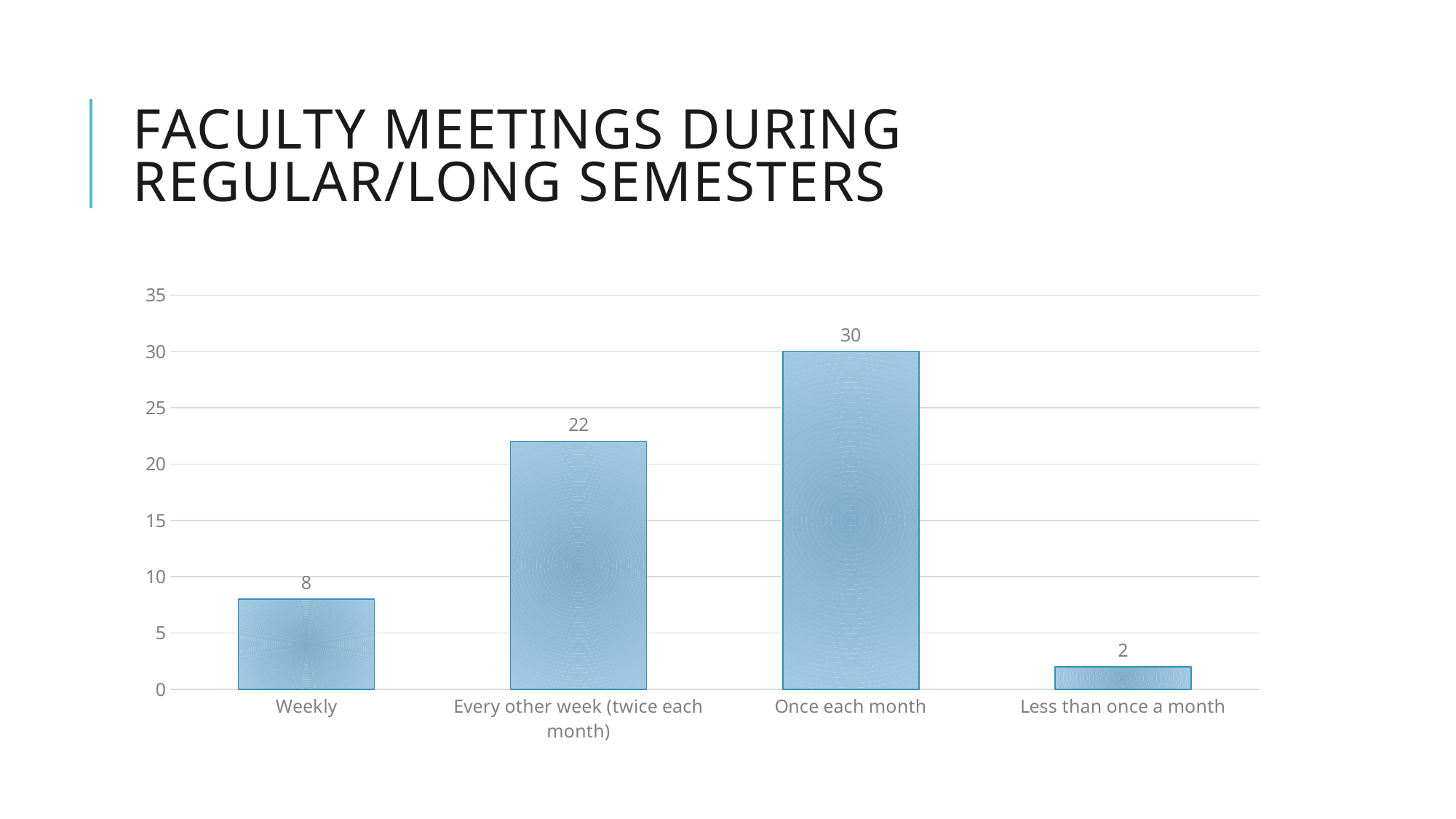
What is the value for Every other week (twice each month)? 22 What is the value for Weekly? 8 Which is larger, the value for Weekly or the value for Every other week (twice each month)? Every other week (twice each month) How many categories are shown on the x axis? 4 Which category has the lowest value? Less than once a month What is the value for Once each month? 30 Which category has the highest value? Once each month What is the difference between the values for Weekly and Less than once a month? 6 What kind of chart is shown on the slide? bar chart Is the value for Once each month greater or less than 25? greater What is the value for Less than once a month? 2 What is the difference between the values for Once each month and Every other week (twice each month)? 8